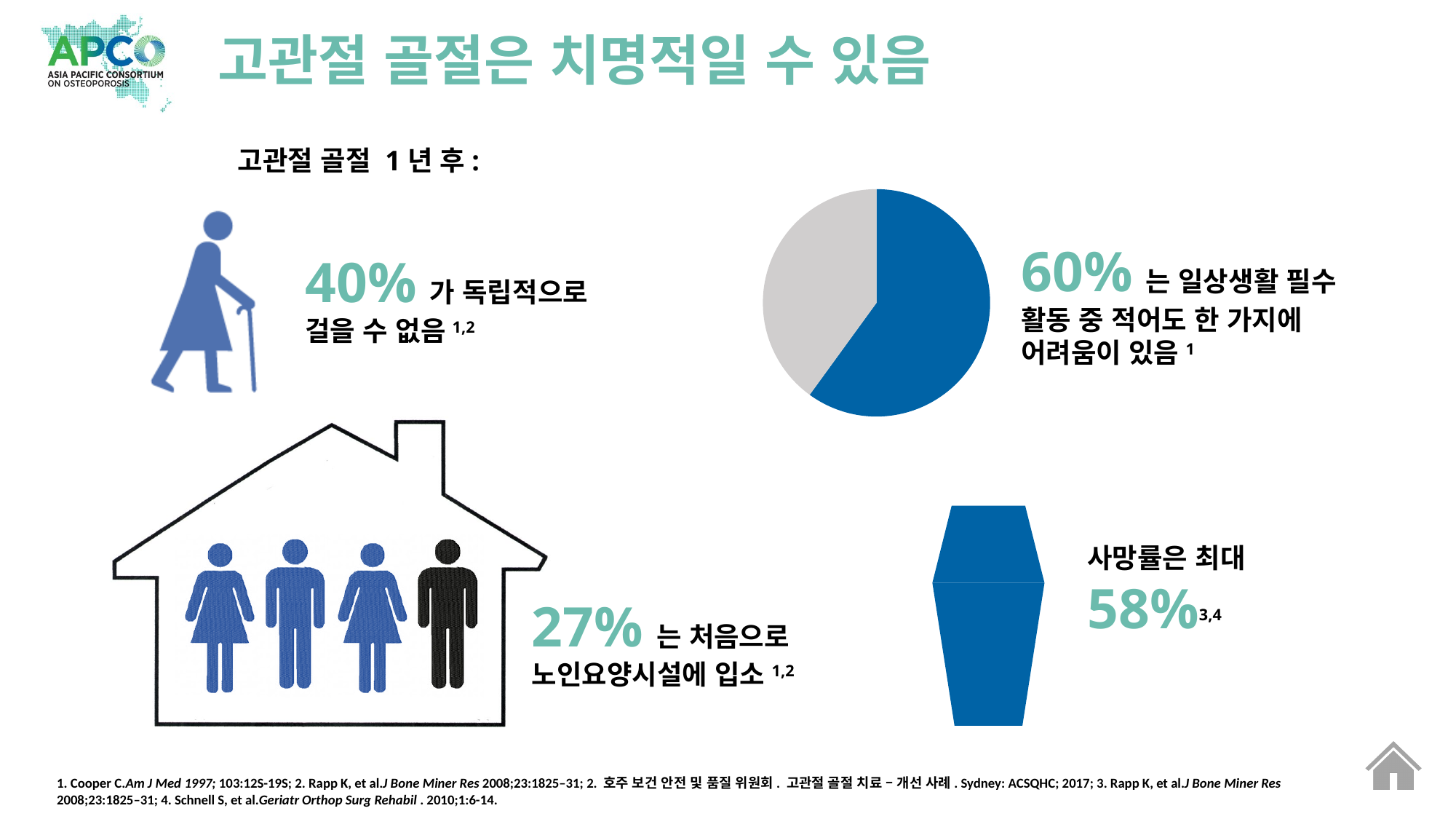
According to the text next to the pie chart, what does the 60% slice represent? 일상생활 필수 활동 중 적어도 한 가지에 어려움이 있음 What share of the pie chart does the grey slice represent? 40% Is the blue slice of the pie chart greater or less than 50% of the pie? greater How many slices does the pie chart have? 2 What share of the pie chart does the blue slice represent? 60% Which slice of the pie chart is larger, the blue one or the grey one? blue What kind of chart is shown on the slide? pie chart What colour is the largest slice of the pie chart? blue